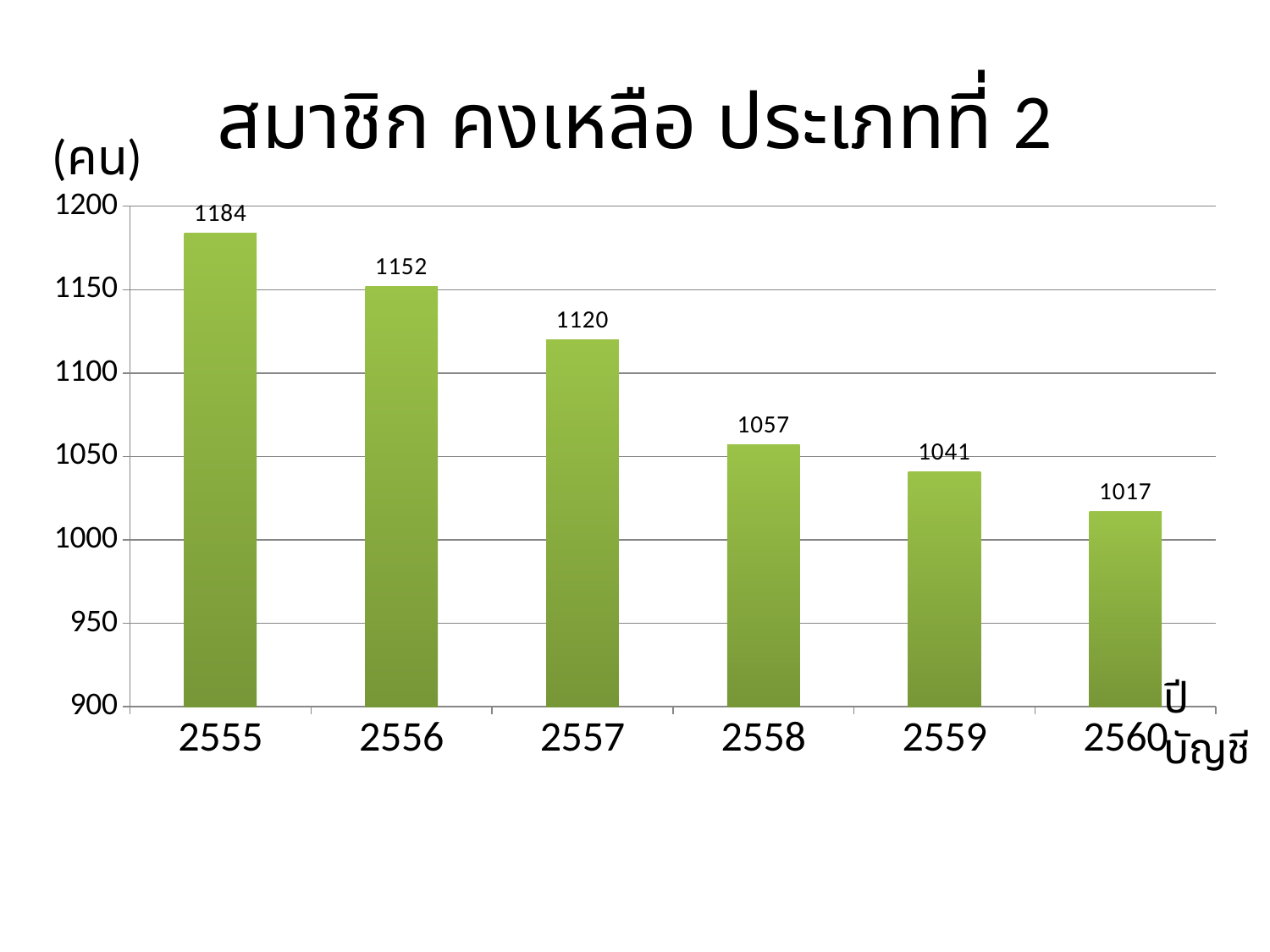
What is the value for 2560? 1017 What is the value for 2555? 1184 How many years are shown on the x axis? 6 Which year has the lowest value? 2560 What is the value for 2558? 1057 Do the values rise or fall from 2555 to 2560? fall What is the difference between the values for 2555 and 2560? 167 Which is larger, the value for 2557 or the value for 2559? 2557 Which year has the highest value? 2555 Is the value for 2558 greater or less than 1100? less What is the difference between the values for 2556 and 2557? 32 What kind of chart is shown on the slide? bar chart